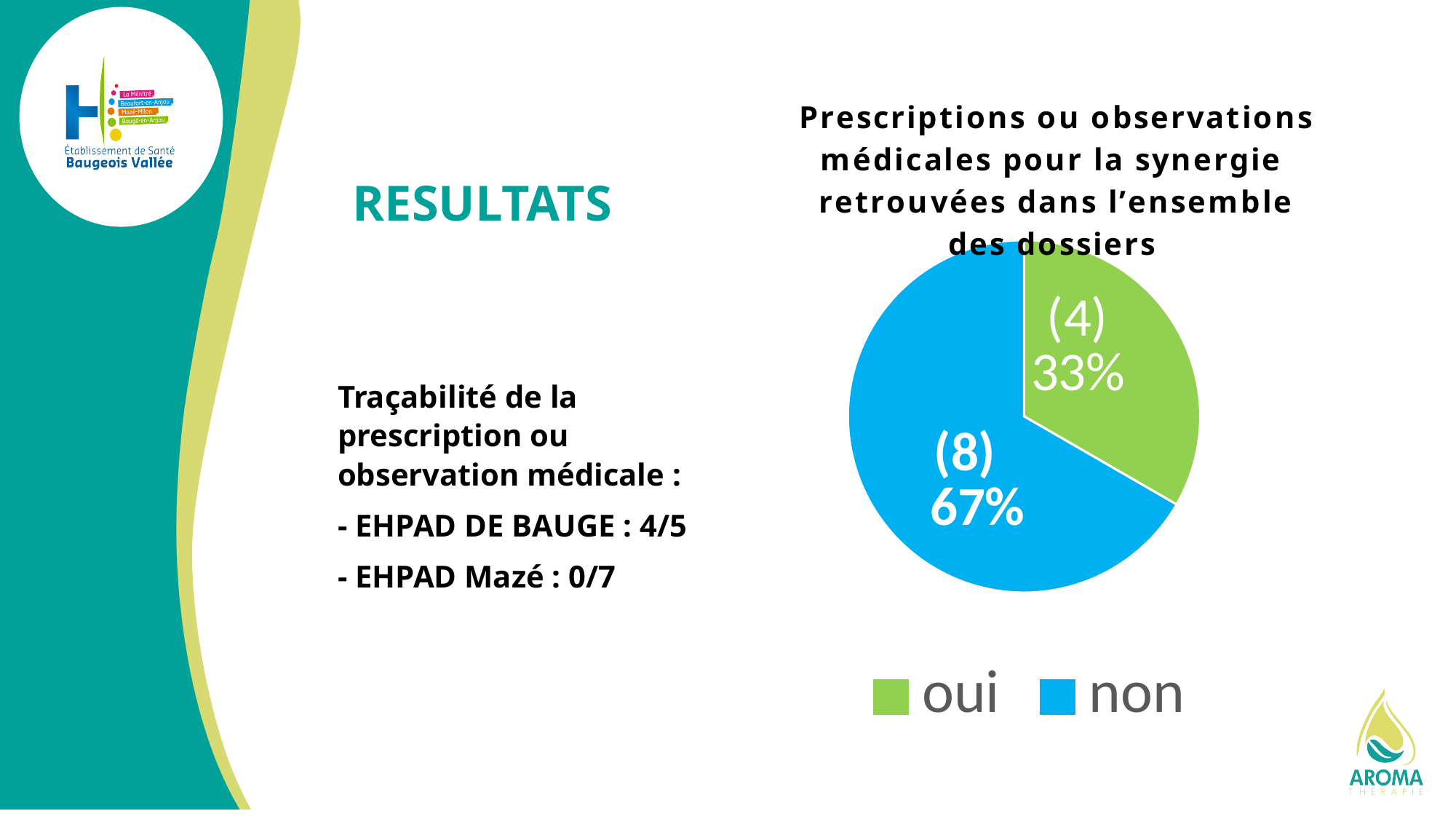
What percentage of the pie does the 'non' slice represent? 67% What colour is the 'oui' slice in the pie chart? green What percentage of the pie does the 'oui' slice represent? 33% What kind of chart is shown on the slide? pie chart How many dossiers are counted in the 'oui' slice? 4 Which slice is the smallest in the pie chart? oui How many dossiers are counted in the 'non' slice? 8 How many entries does the legend list? 2 Which is larger, the 'oui' slice or the 'non' slice? non How many slices does the pie chart have? 2 What is the difference in percentage points between the 'non' and 'oui' slices? 34 Which slice is the largest in the pie chart? non